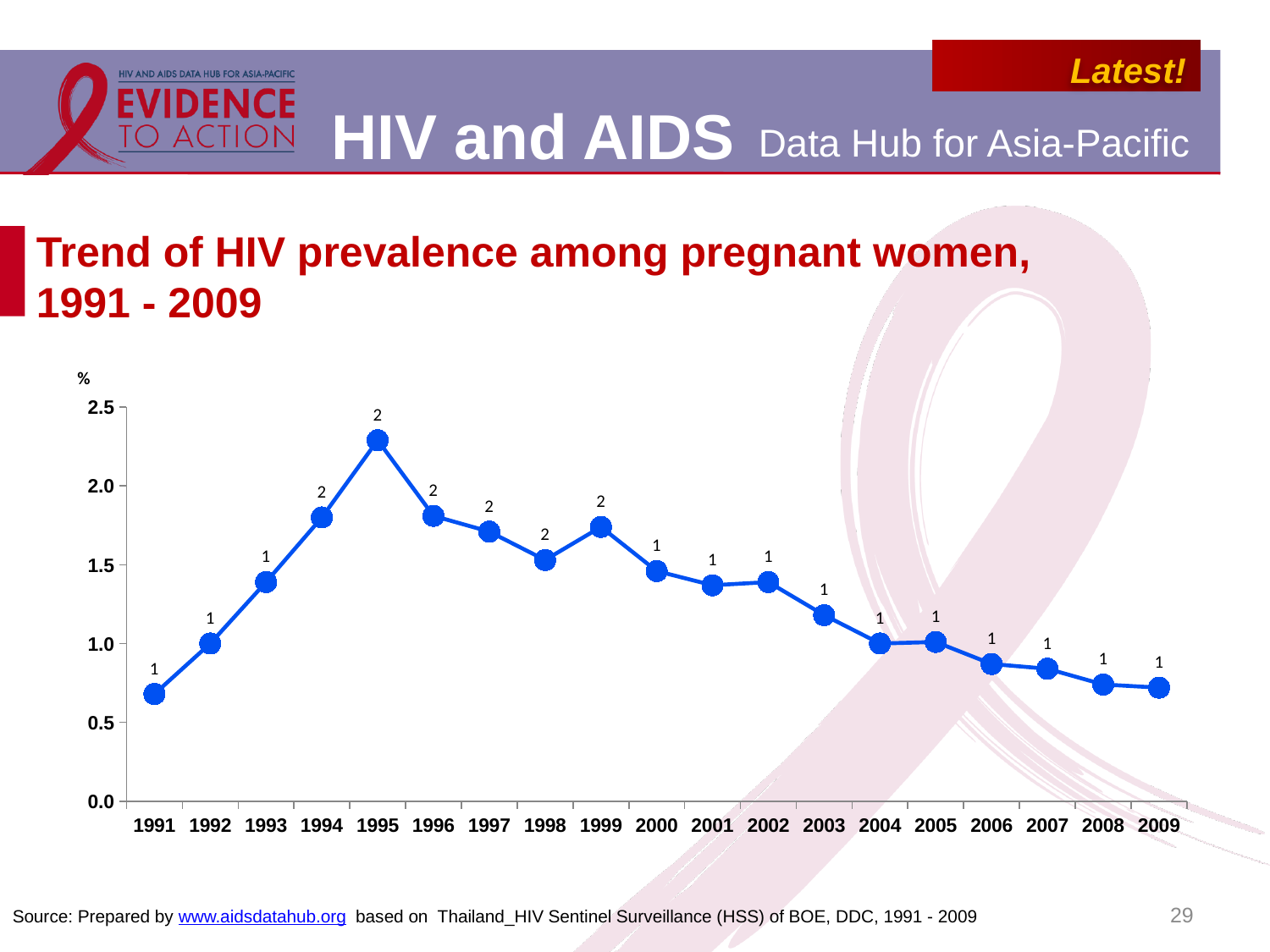
Which year has the highest HIV prevalence among pregnant women? 1995 Is the value for 1991 greater or less than 1.0? less What kind of chart is shown on the slide? line chart Is the value for 2006 greater or less than 1.0? less Is the value for 1999 greater or less than 1.5? greater How many years (data points) are plotted on the chart? 19 Do the values rise or fall from 1995 to 2009? fall Which year has the larger value, 1995 or 1999? 1995 What unit is shown on the y axis of the chart? % Which year has the larger value, 1993 or 2003? 1993